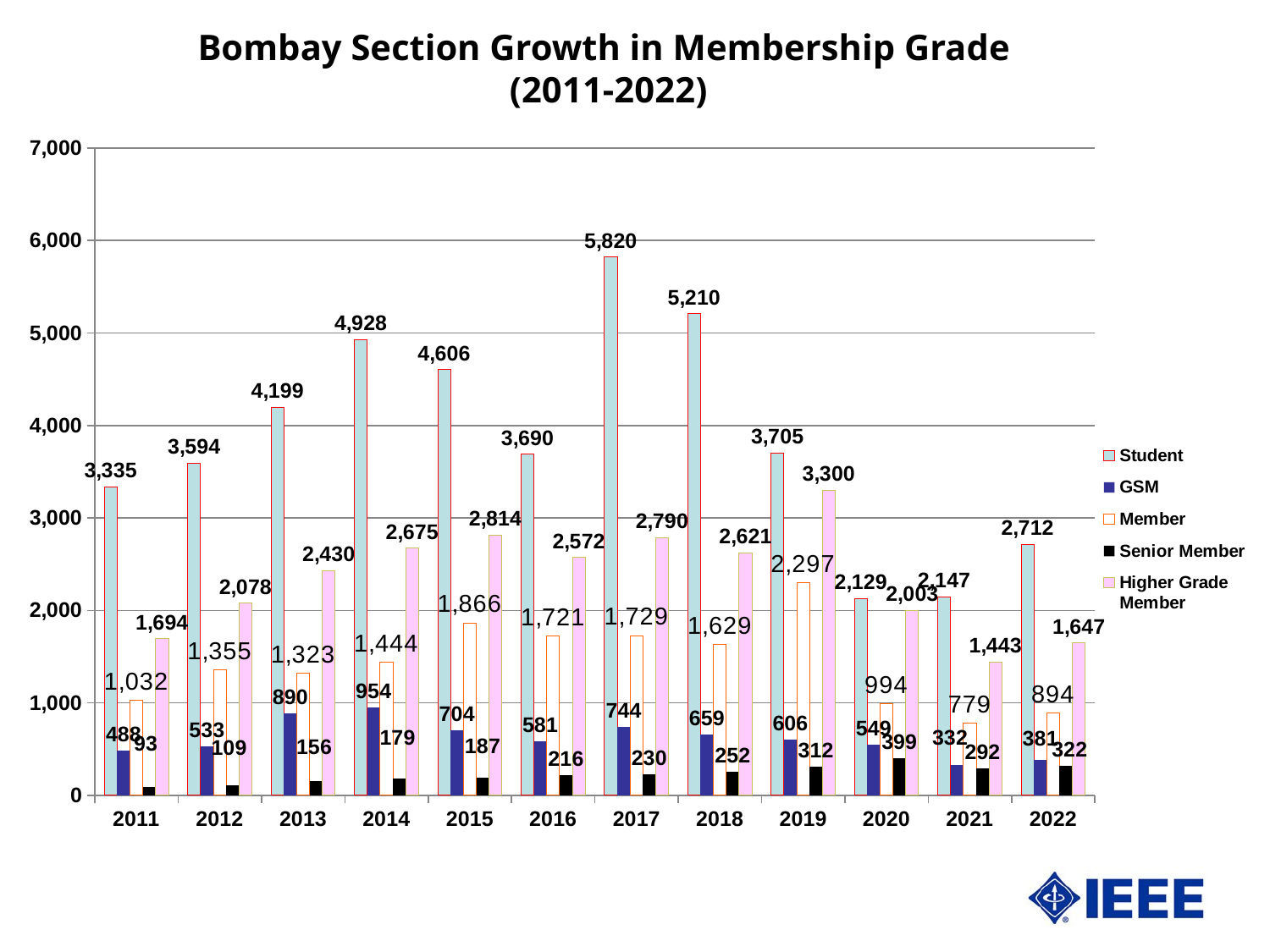
What is the difference between the Student values for 2017 and 2018? 610 Does the Senior Member value rise or fall from 2011 to 2019? rise What kind of chart is shown on the slide? bar chart How many years are shown on the x axis? 12 In which year is the Student value highest? 2017 In which year is the GSM value lowest? 2021 How many series does the legend list? 5 Is the Student value for 2014 greater or less than 4,000? greater Which is larger, the Member value for 2019 or the Higher Grade Member value for 2019? Higher Grade Member value for 2019 What is the Higher Grade Member value for 2019? 3,300 What is the Senior Member value for 2011? 93 What is the Student value for 2017? 5,820